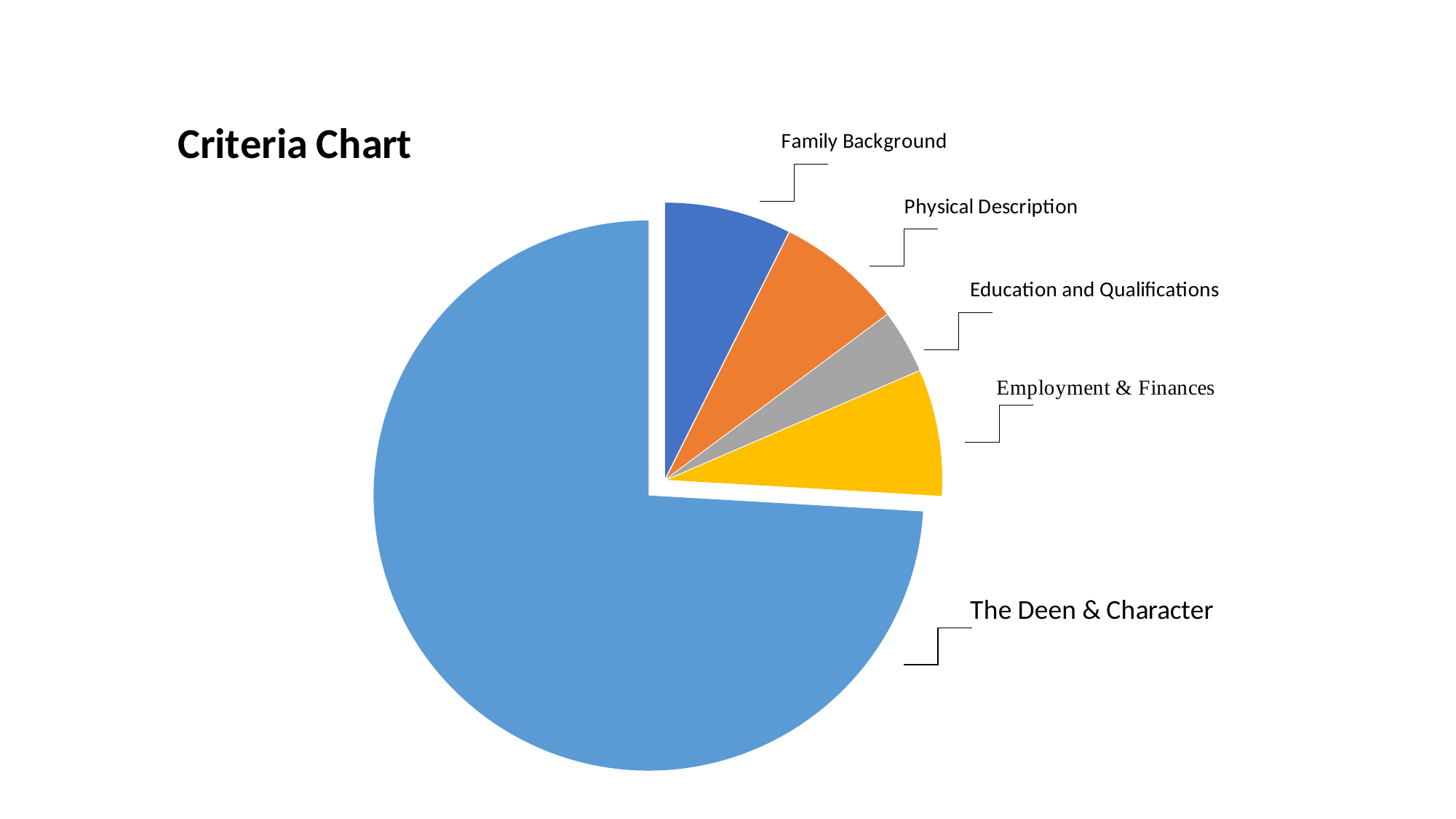
Which slice is larger, The Deen & Character or Family Background? The Deen & Character Which slice is larger, Employment & Finances or Education and Qualifications? Employment & Finances What is the title of the chart? Criteria Chart How many slices does the pie chart have? 5 Which category is represented by the yellow slice? Employment & Finances Which slice is larger, Physical Description or Education and Qualifications? Physical Description What colour is the slice for The Deen & Character? light blue Which category has the smallest slice of the pie? Education and Qualifications Which category has the largest slice of the pie? The Deen & Character What kind of chart is shown on the slide? pie chart